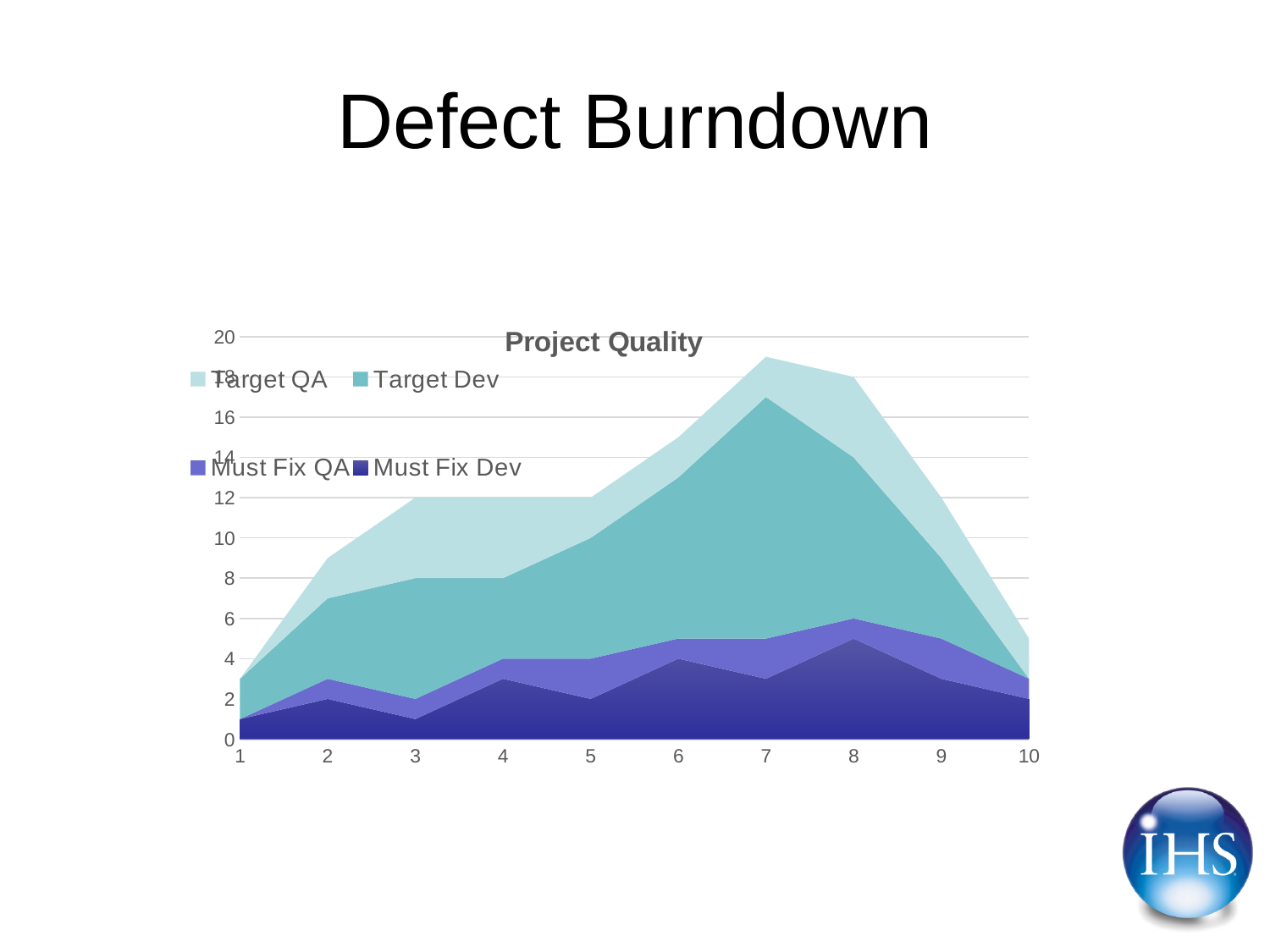
Which series are listed in the chart legend? Target QA, Target Dev, Must Fix QA, Must Fix Dev How many series does the chart legend list? 4 Is the value for Target QA at point 7 greater or less than 16? less What is the title of the chart on the slide? Project Quality Is the value for Target Dev at point 7 greater or less than 14? less At which x-axis point does the Target Dev series reach its highest value? 7 How many points are plotted along the x axis? 10 At which x-axis point is the Target QA series at its lowest value? 1 Is the value for Target QA at point 1 greater or less than 6? less What kind of chart is shown on the slide? area chart